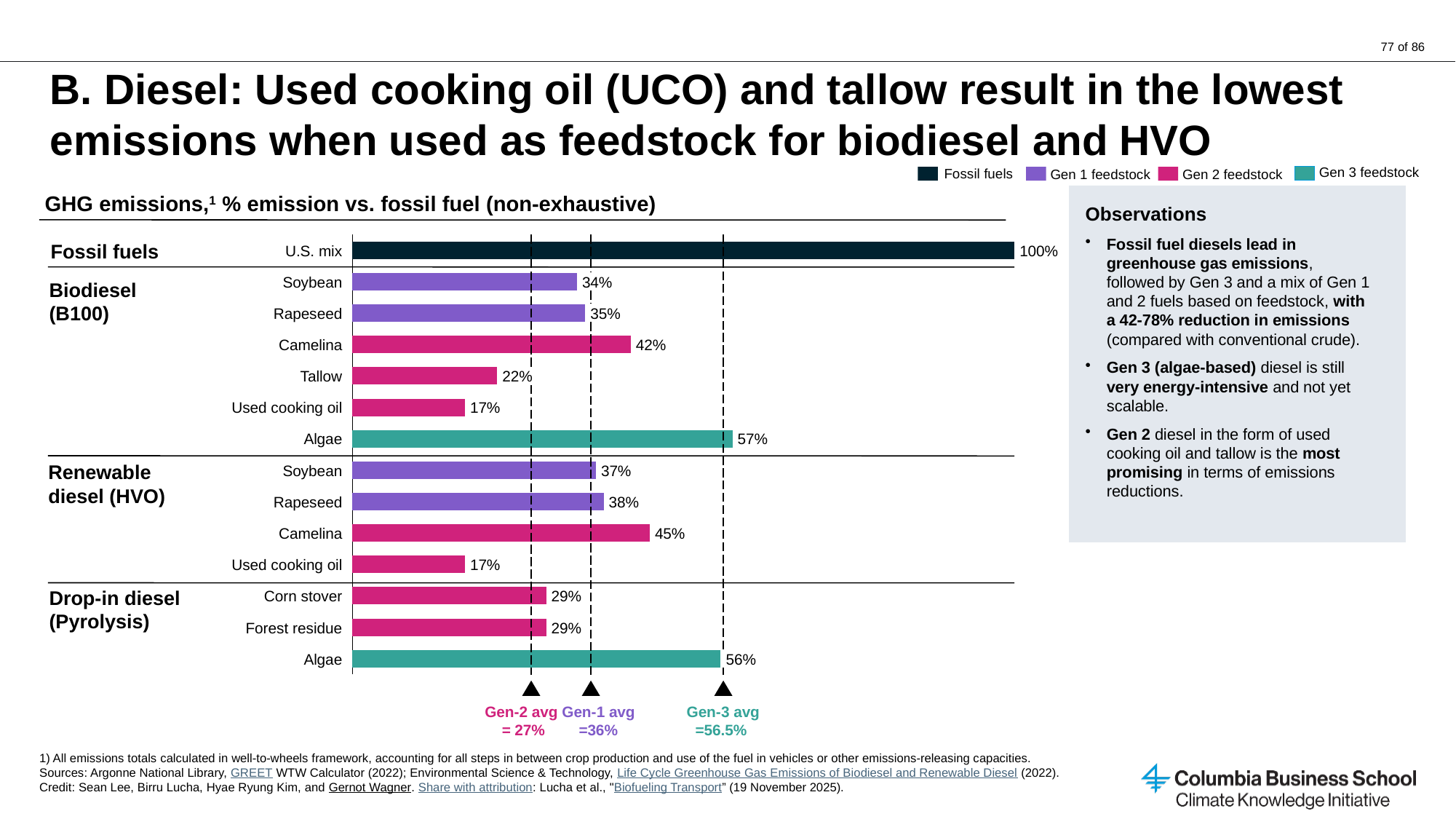
What is the Gen-2 average value marked below the chart? 27% Which feedstock has the lowest GHG emissions value under Biodiesel (B100)? Used cooking oil What is the GHG emissions value for Camelina under Renewable diesel (HVO)? 45% Which has a larger GHG emissions value: Tallow under Biodiesel (B100) or Soybean under Biodiesel (B100)? Soybean What is the GHG emissions value for Used cooking oil under Biodiesel (B100)? 17% How many feedstock bars are shown under Renewable diesel (HVO)? 4 What is the GHG emissions value for Algae under Biodiesel (B100)? 57% What kind of chart is shown on the slide? Bar chart Which category has the highest GHG emissions value on the chart? U.S. mix How many series does the legend list? 4 What is the difference between the Algae value under Biodiesel (B100) and the Algae value under Drop-in diesel (Pyrolysis)? 1% What is the GHG emissions value for Corn stover under Drop-in diesel (Pyrolysis)? 29%